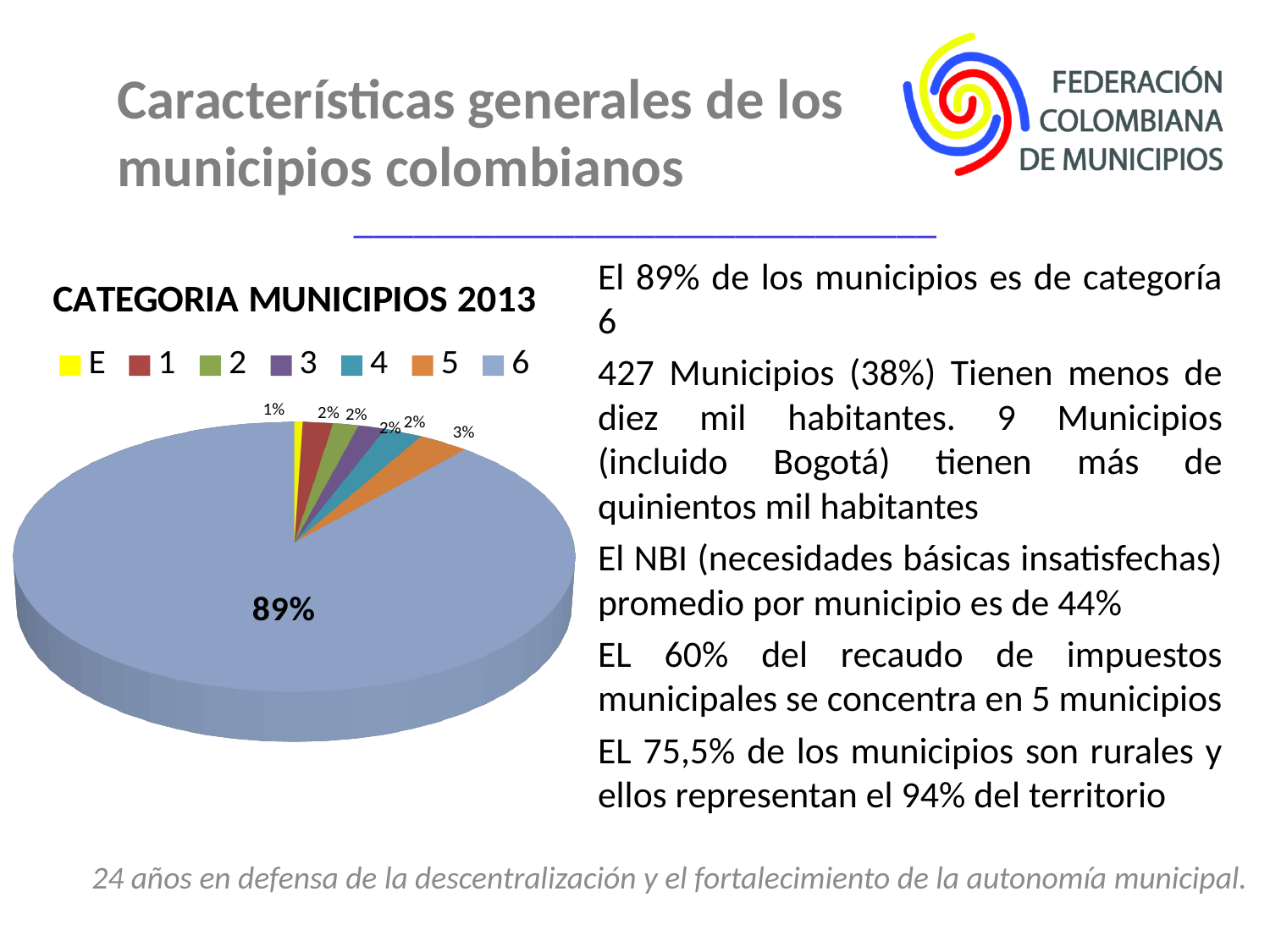
Which has a larger share in the pie chart, category 5 or category E? 5 Which category has the smallest slice in the pie chart? E What is the value shown for category 5 in the pie chart? 3% Which category has the largest slice in the pie chart? 6 What is the value shown for category E in the pie chart? 1% What share of the pie does category 6 represent in the CATEGORIA MUNICIPIOS 2013 chart? 89% What is the difference between the share of category 6 and the share of category 5? 86% How many entries does the legend of the pie chart list? 7 What kind of chart is shown on the slide? Pie chart How many categories are shown in the pie chart? 7 What is the title of the pie chart? CATEGORIA MUNICIPIOS 2013 What colour is the slice for category 6 in the pie chart? Light blue